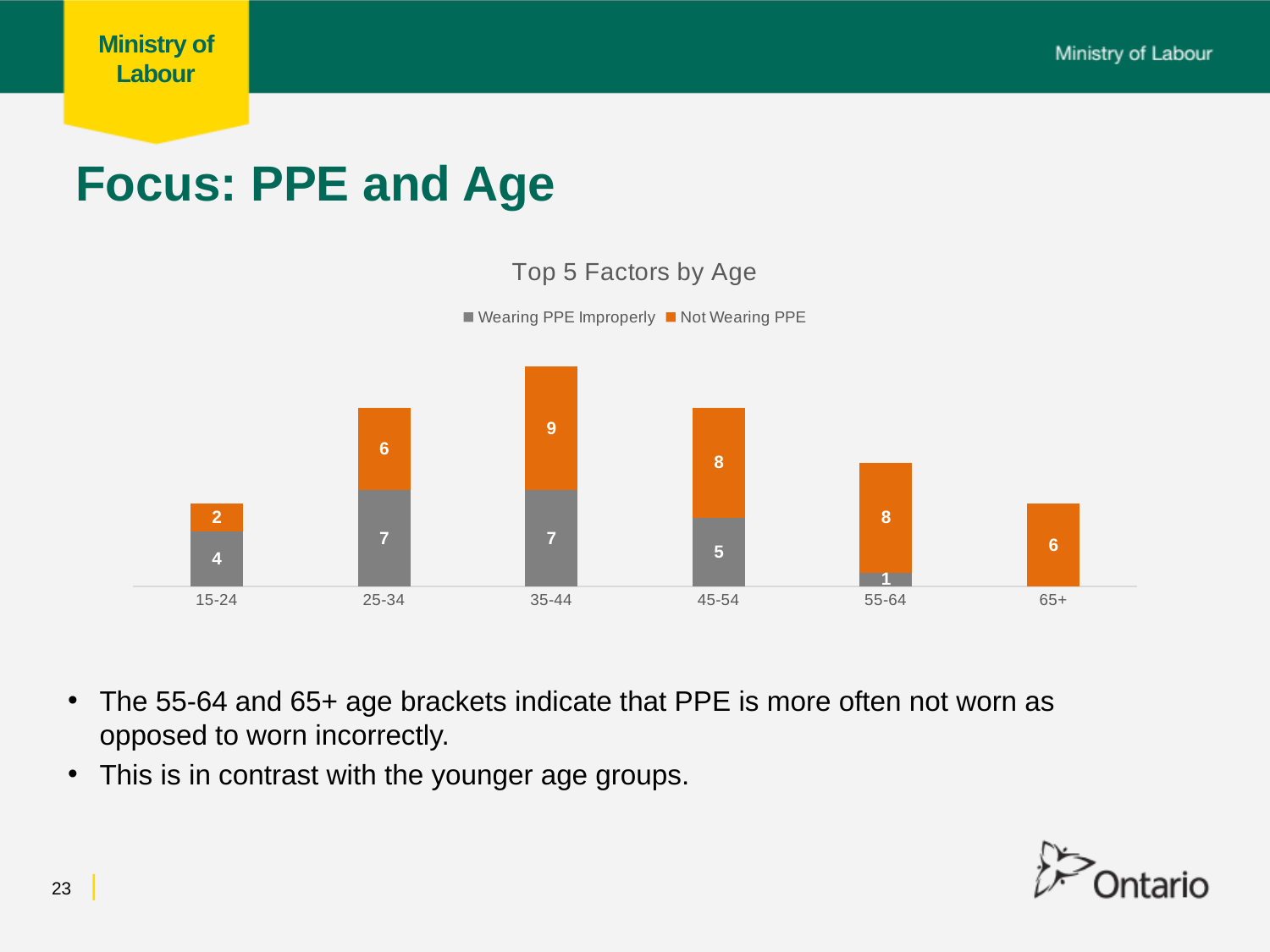
For the 35-44 age group, what is the difference between the Not Wearing PPE value and the Wearing PPE Improperly value? 2 Which age group has the highest Not Wearing PPE value? 35-44 What is the Wearing PPE Improperly value for the 45-54 age group? 5 For the 15-24 age group, which is larger: Wearing PPE Improperly or Not Wearing PPE? Wearing PPE Improperly What kind of chart is shown on the slide? Stacked bar chart What is the title of the chart? Top 5 Factors by Age How many series does the legend of the chart list? 2 Which age group has the tallest stacked bar overall? 35-44 What is the Not Wearing PPE value for the 35-44 age group? 9 What is the total of the stacked bar for the 25-34 age group? 13 How many age groups are shown on the x axis of the chart? 6 What is the Wearing PPE Improperly value for the 55-64 age group? 1